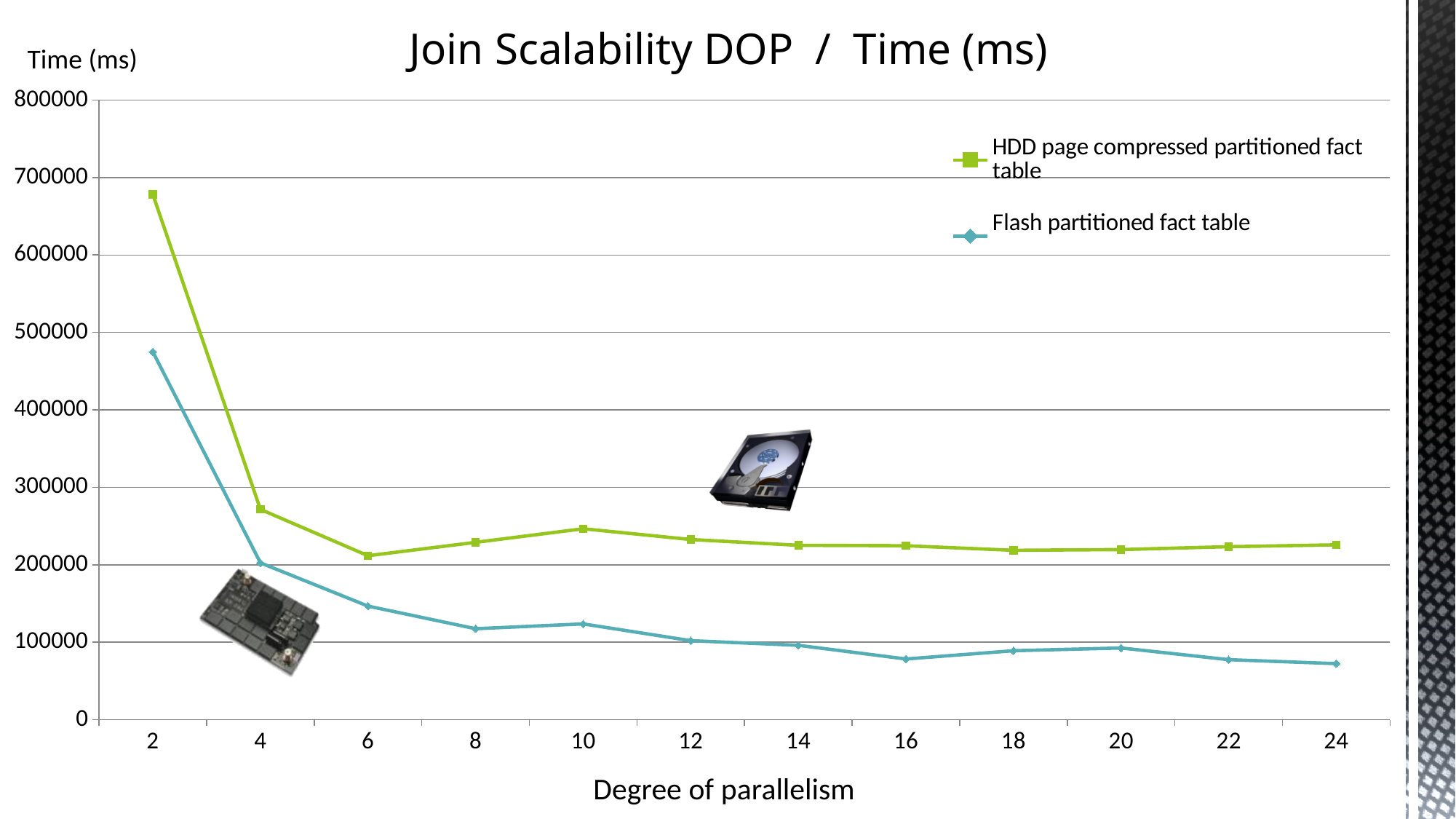
How many series does the legend list? 2 How many degree-of-parallelism values are plotted along the x axis? 12 Is the value for the Flash partitioned fact table at a degree of parallelism of 2 greater or less than 500000? less What is the title of the chart? Join Scalability DOP / Time (ms) Is the value for the HDD page compressed partitioned fact table at a degree of parallelism of 24 greater or less than 200000? greater Which series has the highest value at a degree of parallelism of 2? HDD page compressed partitioned fact table Is the value for the Flash partitioned fact table at a degree of parallelism of 24 greater or less than 100000? less What kind of chart is shown on the slide? line chart What is the label of the x axis? Degree of parallelism Does the Flash partitioned fact table series generally rise or fall as the degree of parallelism increases? fall At a degree of parallelism of 12, which series has the larger value, HDD page compressed partitioned fact table or Flash partitioned fact table? HDD page compressed partitioned fact table